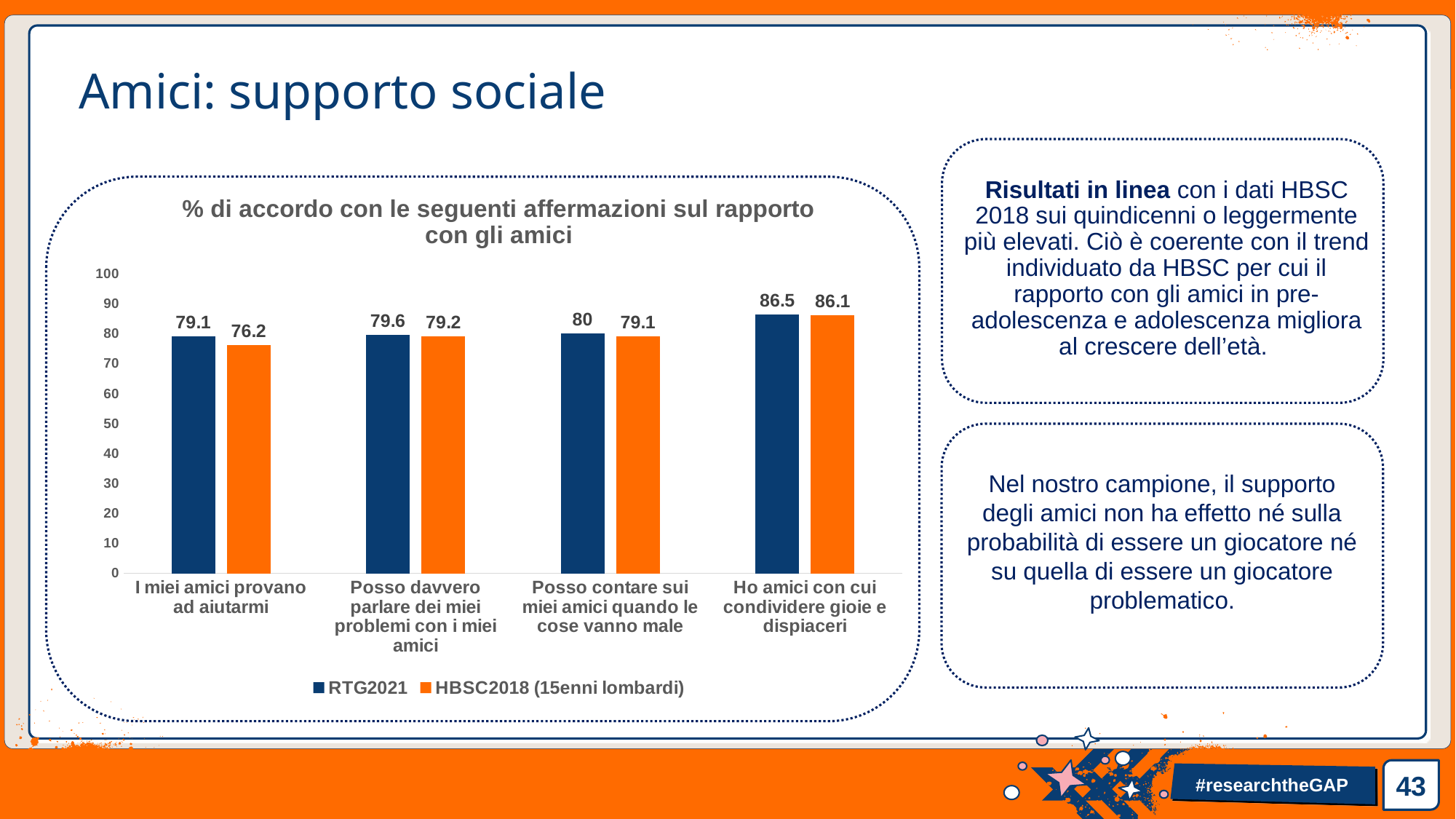
What is the RTG2021 value for "I miei amici provano ad aiutarmi"? 79.1 How many statements (categories) are shown on the x axis of the chart? 4 Which statement has the highest RTG2021 value? Ho amici con cui condividere gioie e dispiaceri For "Posso contare sui miei amici quando le cose vanno male", which series has the larger value, RTG2021 or HBSC2018 (15enni lombardi)? RTG2021 How many series does the chart legend list? 2 What type of chart is shown on the slide? Bar chart What is the HBSC2018 (15enni lombardi) value for "Posso contare sui miei amici quando le cose vanno male"? 79.1 What is the HBSC2018 (15enni lombardi) value for "Posso davvero parlare dei miei problemi con i miei amici"? 79.2 What is the title of the chart? % di accordo con le seguenti affermazioni sul rapporto con gli amici Which statement has the lowest HBSC2018 (15enni lombardi) value? I miei amici provano ad aiutarmi What is the RTG2021 value for "Ho amici con cui condividere gioie e dispiaceri"? 86.5 What is the difference between the RTG2021 and HBSC2018 values for "I miei amici provano ad aiutarmi"? 2.9